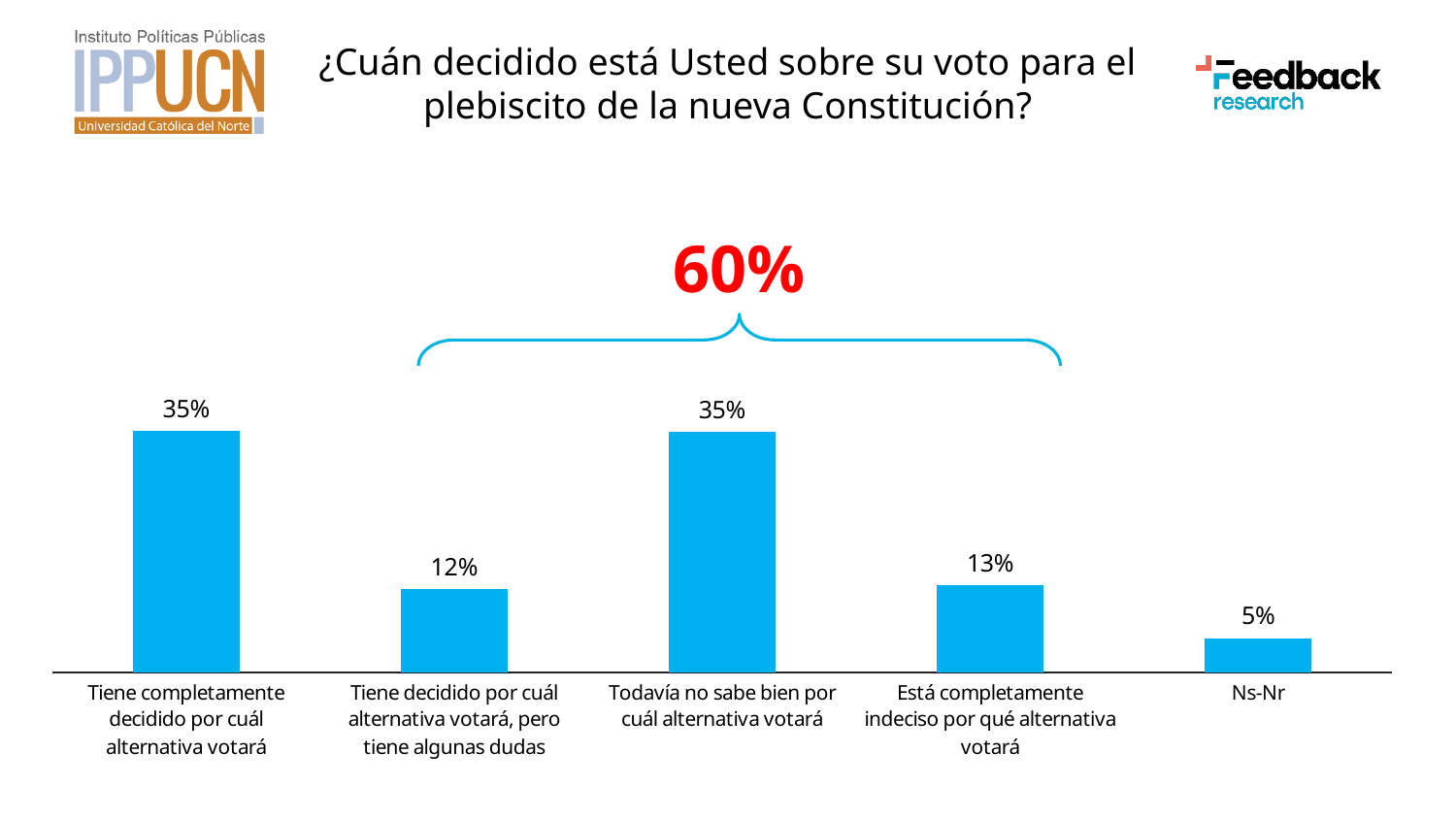
What is the value for "Está completamente indeciso por qué alternativa votará"? 13% What percentage of respondents said they have completely decided which alternative they will vote for ("Tiene completamente decidido por cuál alternativa votará")? 35% How many categories are shown in the chart? 5 Which is larger: the value for "Está completamente indeciso por qué alternativa votará" or the value for "Ns-Nr"? Está completamente indeciso por qué alternativa votará What percentage is shown for the "Ns-Nr" category? 5% What percentage is shown for "Todavía no sabe bien por cuál alternativa votará"? 35% What is the value shown for "Tiene decidido por cuál alternativa votará, pero tiene algunas dudas"? 12% What type of chart is shown on the slide? Bar chart What percentage is printed in red above the bracket spanning the three middle bars? 60% What is the difference between the value for "Tiene completamente decidido por cuál alternativa votará" and the value for "Ns-Nr"? 30% Which category has the lowest value in the chart? Ns-Nr What is the difference between the values for "Está completamente indeciso por qué alternativa votará" and "Tiene decidido por cuál alternativa votará, pero tiene algunas dudas"? 1%